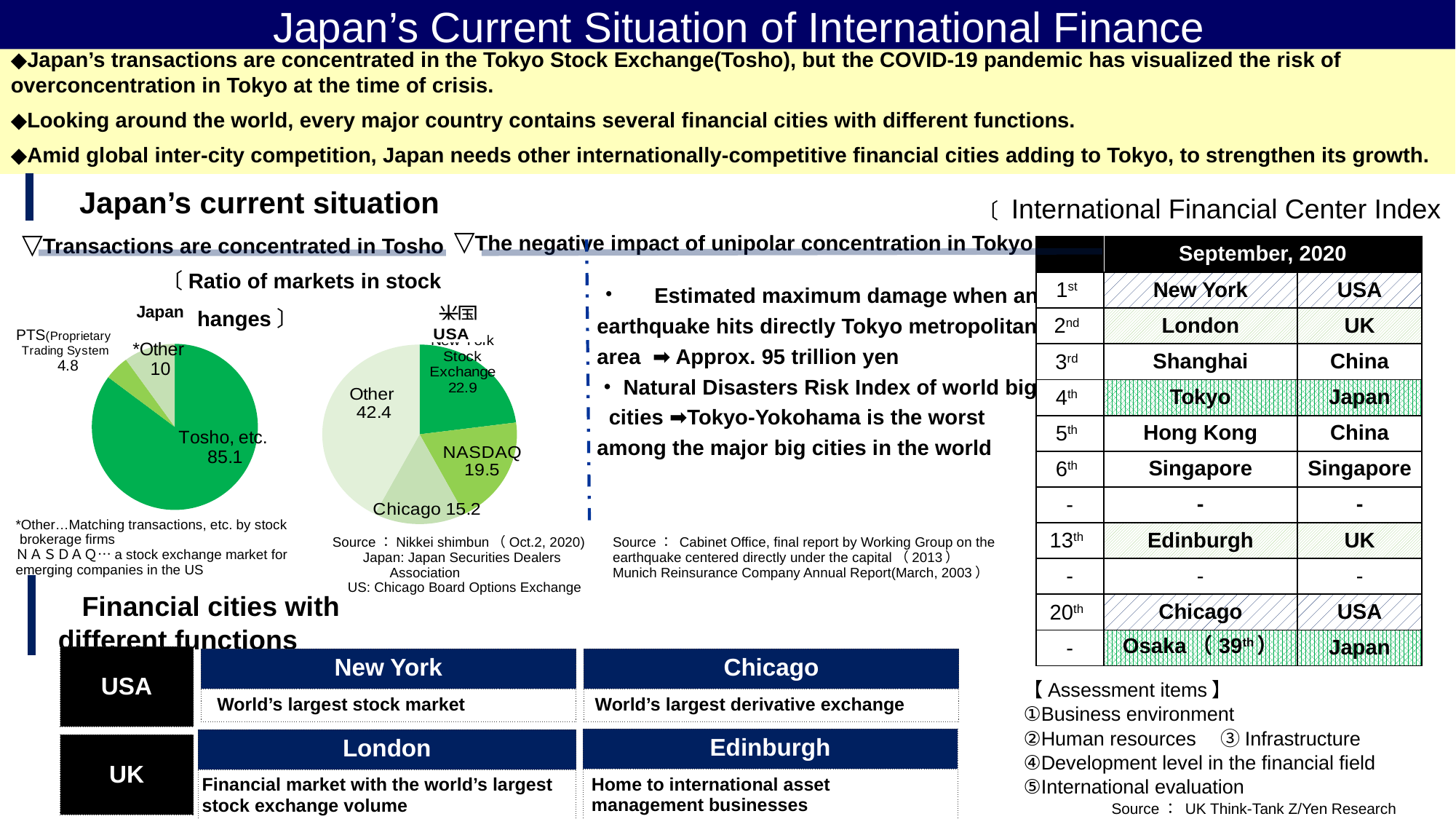
In the Japan pie chart, what is the value for *Other? 10 How many slices does the Japan pie chart have? 3 In the Japan pie chart, which category has the largest share? Tosho, etc. In the Japan pie chart, which category has the smallest share? PTS In the USA pie chart, what is the value for Chicago? 15.2 In the Japan pie chart, what is the difference between Tosho, etc. and *Other? 75.1 In the Japan pie chart, what is the value for PTS (Proprietary Trading System)? 4.8 In the USA pie chart, what is the difference between Other and New York Stock Exchange? 19.5 In the Japan pie chart, what is the value for Tosho, etc.? 85.1 What type of chart is used to show the ratio of markets in stock exchanges for Japan? Pie chart In the USA pie chart, what is the value for NASDAQ? 19.5 In the USA pie chart, which is larger, New York Stock Exchange or NASDAQ? New York Stock Exchange